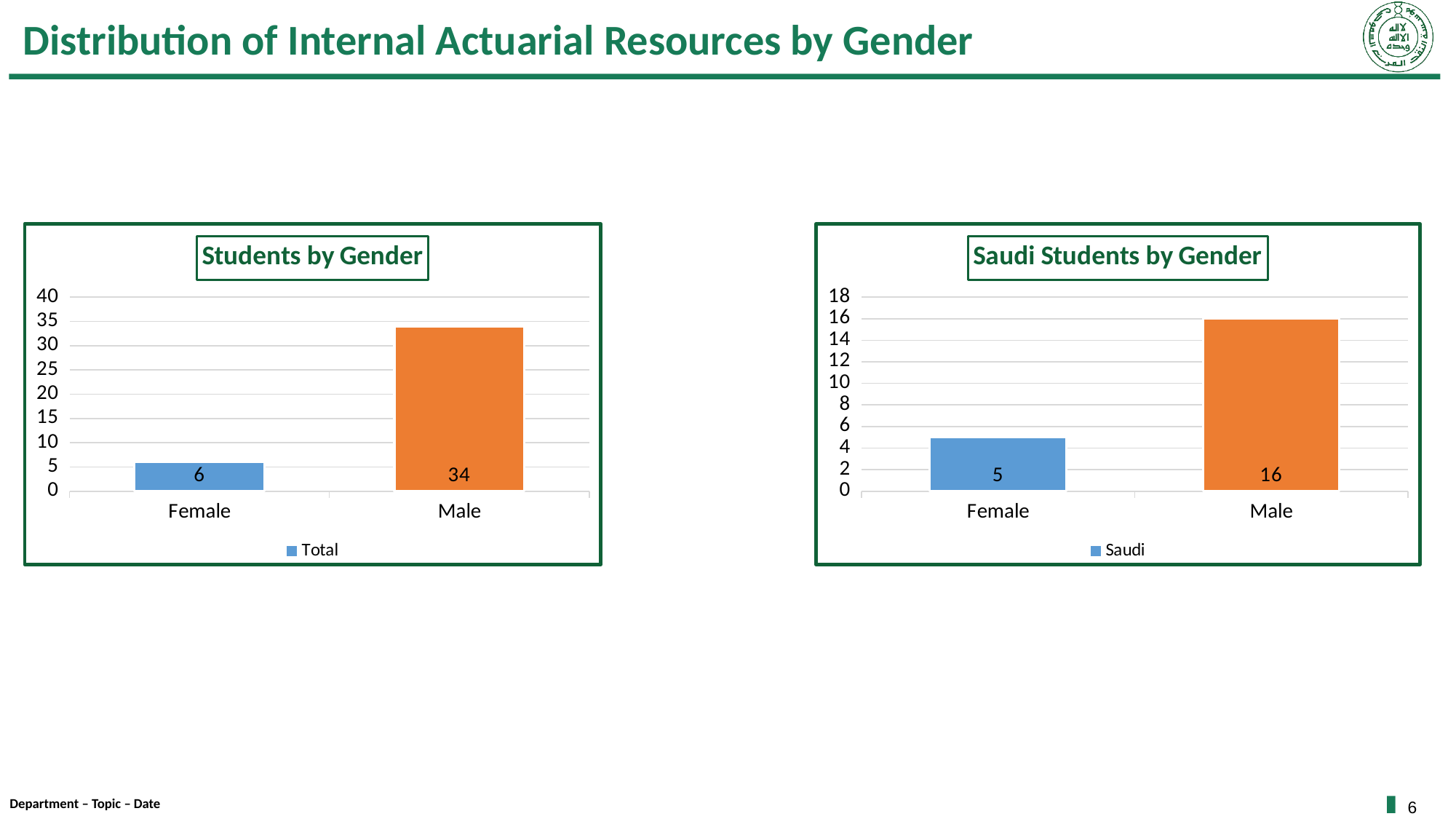
In the 'Saudi Students by Gender' chart, what is the value for Male? 16 What series name does the legend of the 'Students by Gender' chart show? Total In the 'Saudi Students by Gender' chart, is the value for Male greater or less than 10? greater In the 'Saudi Students by Gender' chart, what is the value for Female? 5 In the 'Saudi Students by Gender' chart, which category has the lowest value? Female How many categories are shown in the 'Students by Gender' chart? 2 In the 'Students by Gender' chart, what is the value for Male? 34 In the 'Students by Gender' chart, which category has the highest value? Male In the 'Students by Gender' chart, what is the difference between the Male and Female values? 28 What kind of chart is the 'Saudi Students by Gender' chart? Bar chart In the 'Saudi Students by Gender' chart, what is the difference between the Male and Female values? 11 In the 'Students by Gender' chart, what is the value for Female? 6